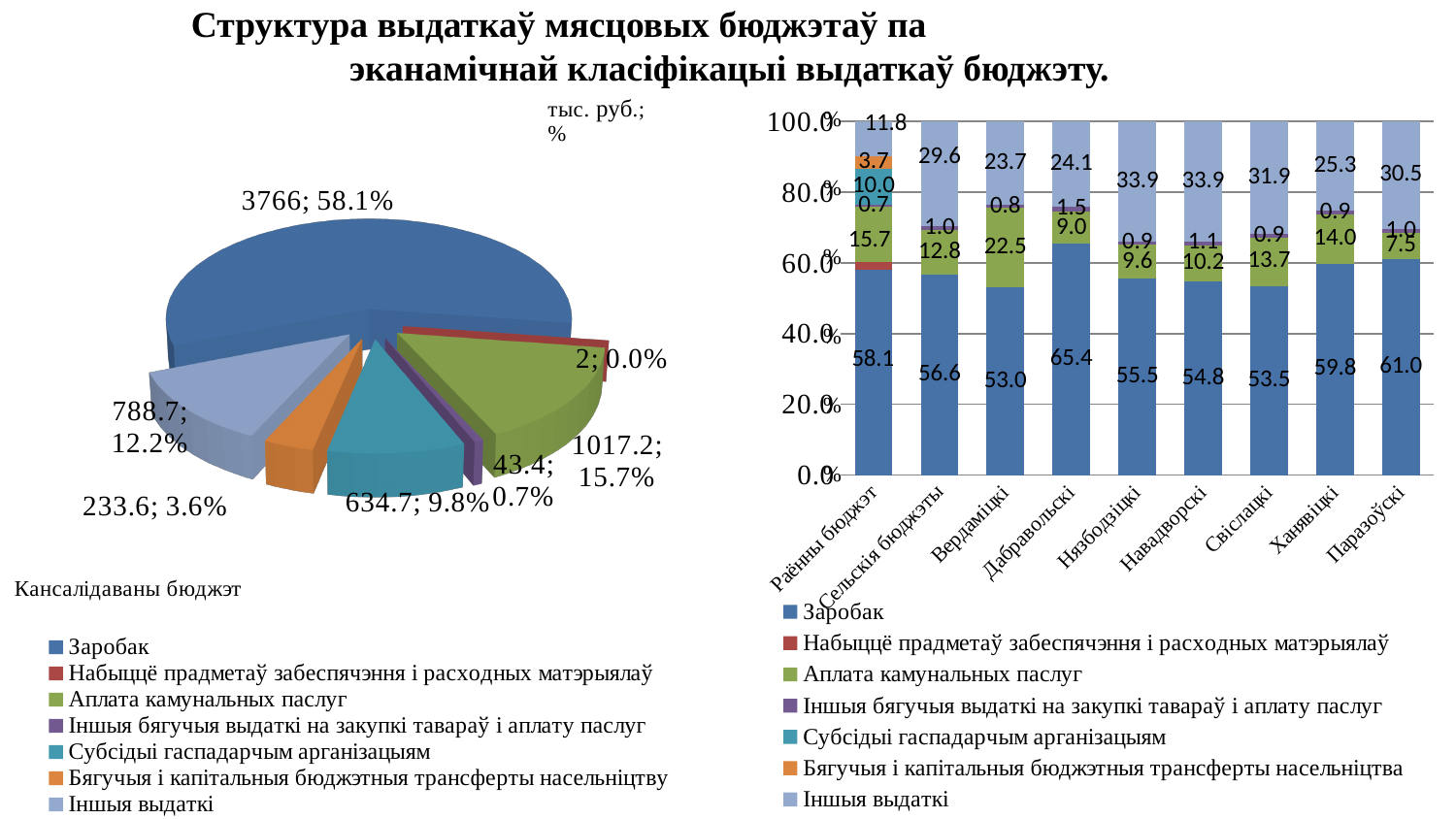
In the pie chart on the left, what share does the Іншыя выдаткі slice have? 12.2% In the stacked bar chart on the right, how many categories are shown on the x axis? 9 In the stacked bar chart on the right, what is the difference between the Заробак values for Паразоўскі and Вердаміцкі? 8.0 In the stacked bar chart on the right, how many series does the legend list? 7 What kind of chart is the chart on the left? Pie chart In the stacked bar chart on the right, which category has the highest Заробак value? Дабравольскі What kind of chart is the chart on the right? Stacked bar chart In the stacked bar chart on the right, what is the Заробак value for Дабравольскі? 65.4 In the pie chart on the left, what is the value shown for Субсідыі гаспадарчым арганізацыям? 634.7 In the pie chart on the left, which category has the smallest slice? Набыццё прадметаў забеспячэння і расходных матэрыялаў In the pie chart on the left, what value and share are shown for the Заробак slice? 3766; 58.1% In the pie chart on the left, which category has the largest slice? Заробак